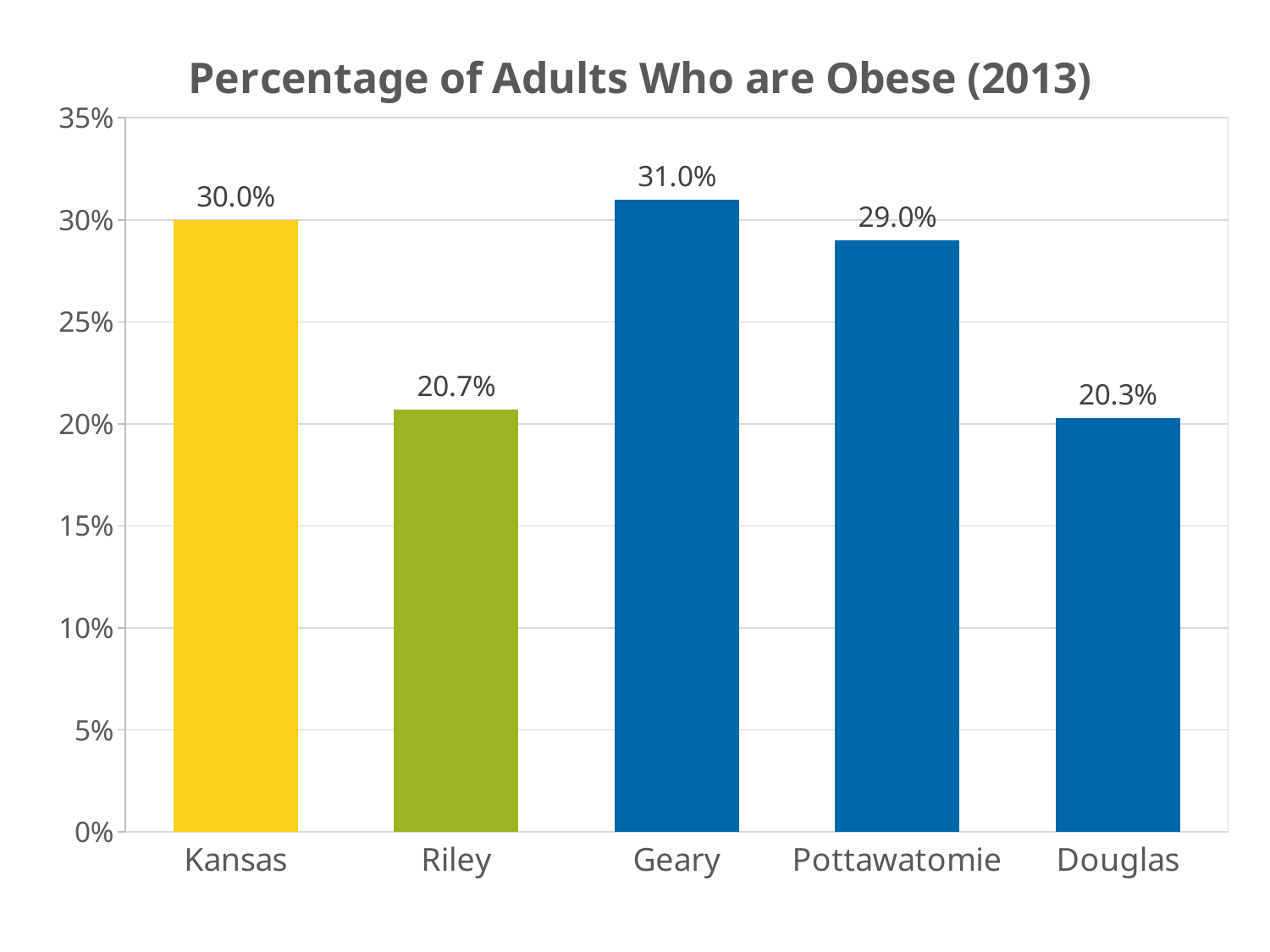
What is the percentage of adults who are obese in Kansas? 30.0% Which category has the lowest percentage of obese adults? Douglas Which has a higher percentage of obese adults, Geary or Pottawatomie? Geary How many categories are shown on the chart? 5 What is the title of the chart? Percentage of Adults Who are Obese (2013) What is the percentage of adults who are obese in Riley? 20.7% Which category has the highest percentage of obese adults? Geary What is the difference between the obesity percentages for Kansas and Riley? 9.3% Is the value for Riley greater or less than 25%? less What is the percentage of adults who are obese in Pottawatomie? 29.0% What is the difference between the obesity percentages for Geary and Douglas? 10.7% What kind of chart is shown on the slide? Bar chart